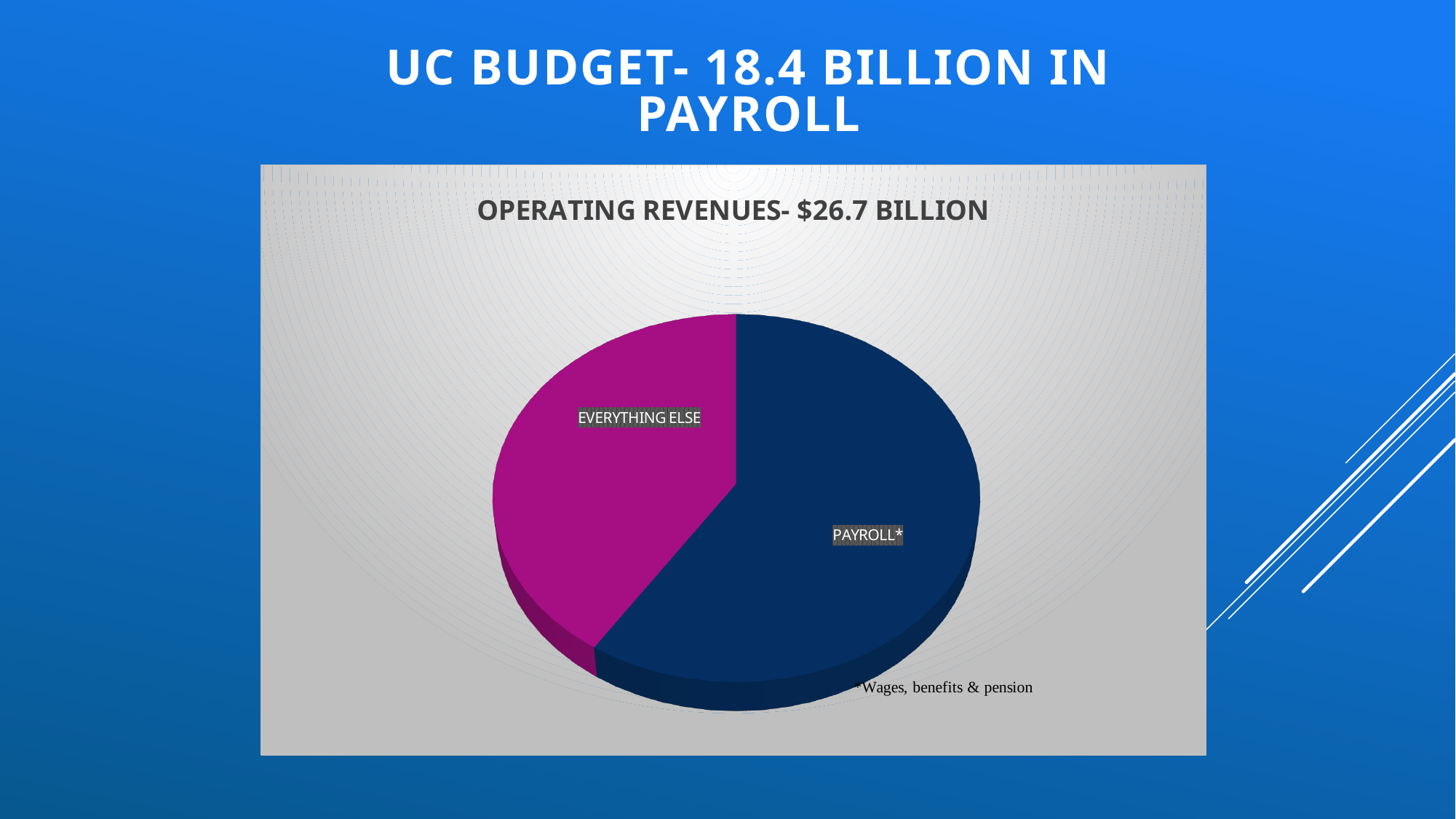
How many slices does the pie chart have? 2 What colour is the PAYROLL* slice of the pie chart? dark blue What kind of chart is shown on the slide? pie chart What is the title of the pie chart? OPERATING REVENUES- $26.7 BILLION Does the PAYROLL* slice take up more or less than half of the pie? more Which slice of the pie chart is the largest? PAYROLL* Which slice of the pie chart is the smallest? EVERYTHING ELSE Which slice is larger, PAYROLL* or EVERYTHING ELSE? PAYROLL*